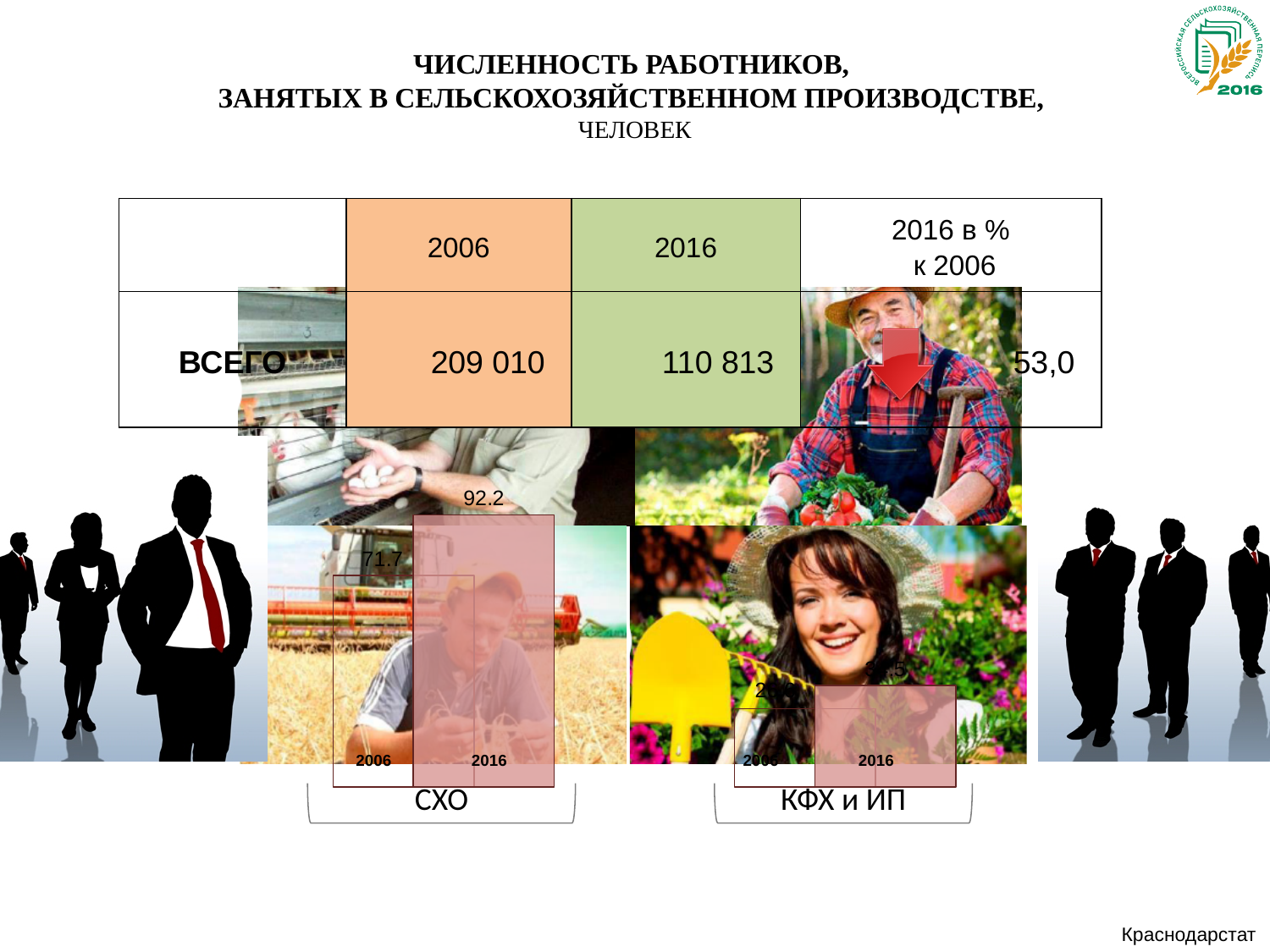
On the СХО chart, do the values rise or fall from 2006 to 2016? rise On the СХО chart, what is the value for 2006? 71.7 How many bars are shown on the КФХ и ИП chart? 2 On the СХО chart, what is the difference between the 2016 and 2006 values? 20.5 On the СХО chart, what is the value for 2016? 92.2 On the СХО chart, which year has the lowest value? 2006 On the СХО chart, which year has the higher value, 2006 or 2016? 2016 On the КФХ и ИП chart, which year has the taller bar, 2006 or 2016? 2016 In the table, what is the total (ВСЕГО) number of workers for 2016? 110 813 How many bars are shown on the СХО chart? 2 In the table, what is 2016 as a percentage of 2006 for ВСЕГО? 53,0 What type of chart is used for the СХО and КФХ и ИП data? bar chart